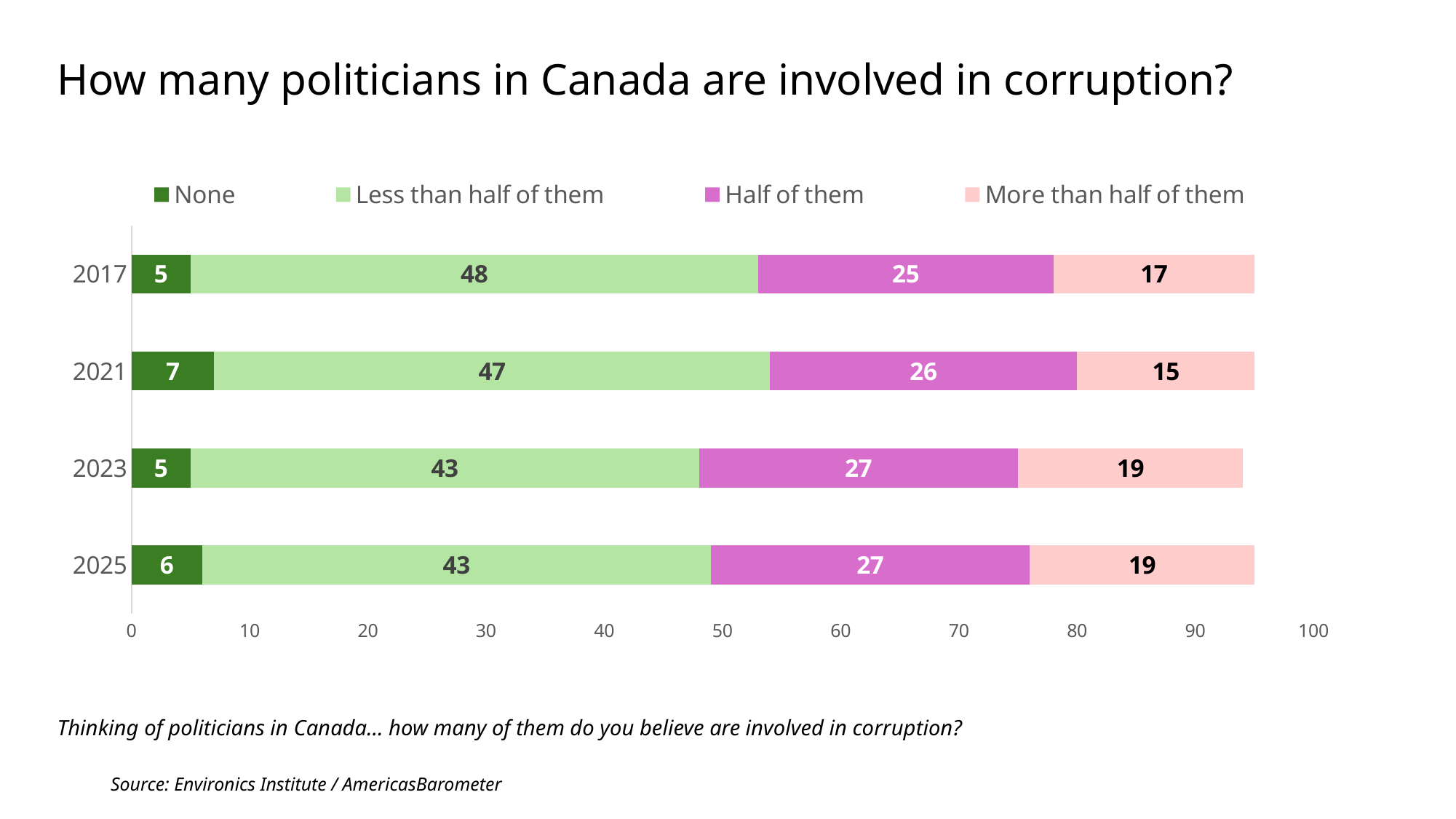
How many series does the legend list? 4 What is the total of the stacked bar for 2021? 95 What kind of chart is shown on the slide? Stacked bar chart What is the value for "Half of them" in 2023? 27 What is the value for "Less than half of them" in 2017? 48 Which is larger: the "Half of them" value in 2017 or in 2021? 2021 In which year is the value for "More than half of them" lowest? 2021 What is the value for "More than half of them" in 2025? 19 In which year is the value for "Less than half of them" highest? 2017 How many years are shown on the chart? 4 What is the value for "None" in 2021? 7 What is the difference between the "Less than half of them" values for 2017 and 2025? 5